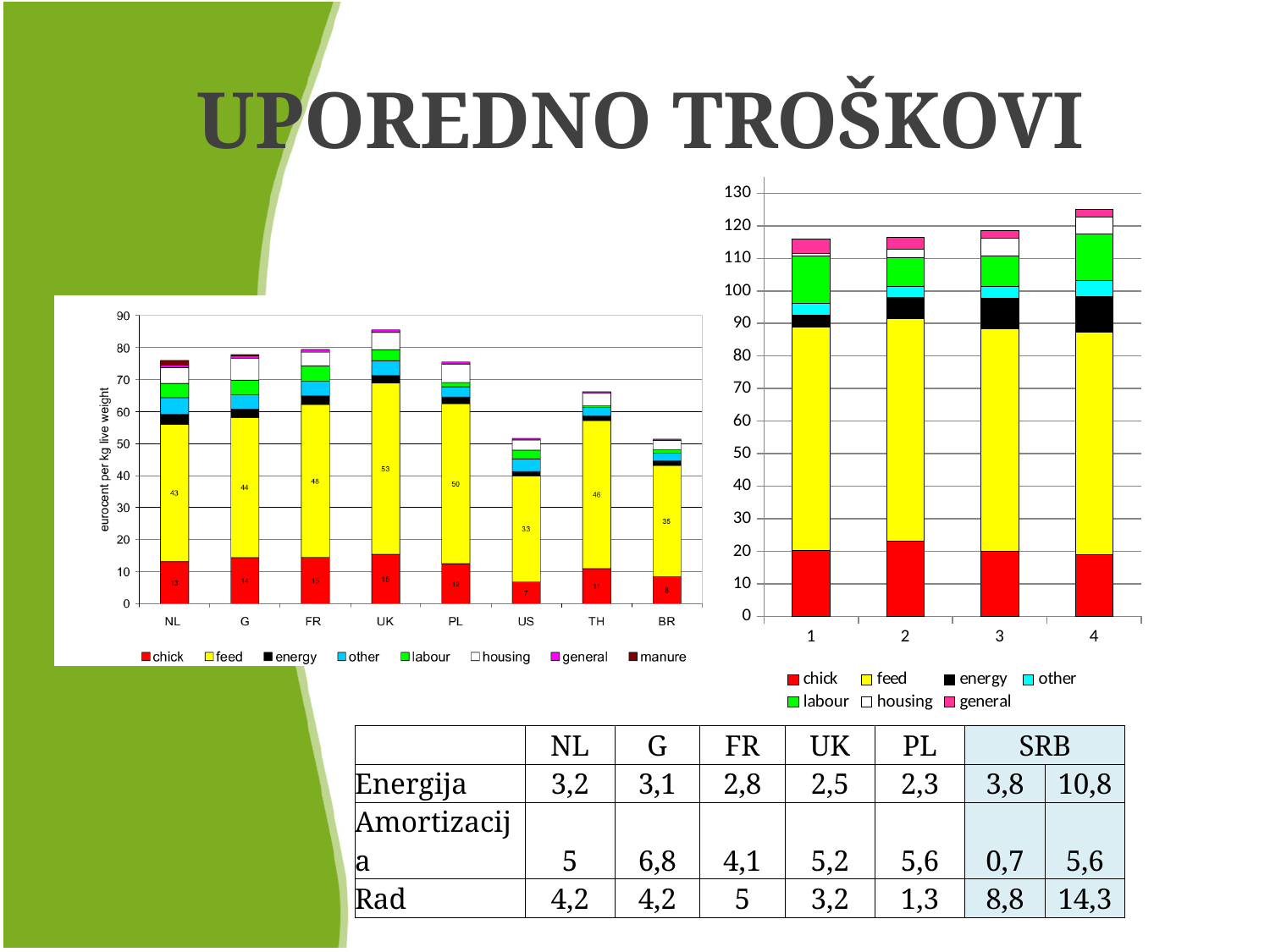
In the left chart, what is the chick value for US? 7 In the left chart, how many series does the legend list? 8 In the left chart, which is larger, the feed value for PL or the feed value for TH? PL In the left chart, what is the feed value for UK? 53 In the left chart, which country has the highest feed value? UK In the right chart, is the total of bar 4 greater or less than 120? greater What kind of chart is the right chart? stacked bar chart In the left chart, what is the difference between the feed values for UK and US? 20 In the right chart, is the chick value for category 2 greater or less than 20? greater In the right chart, how many series does the legend list? 7 In the left chart, how many countries are shown on the x axis? 8 In the left chart, which country has the lowest feed value? US